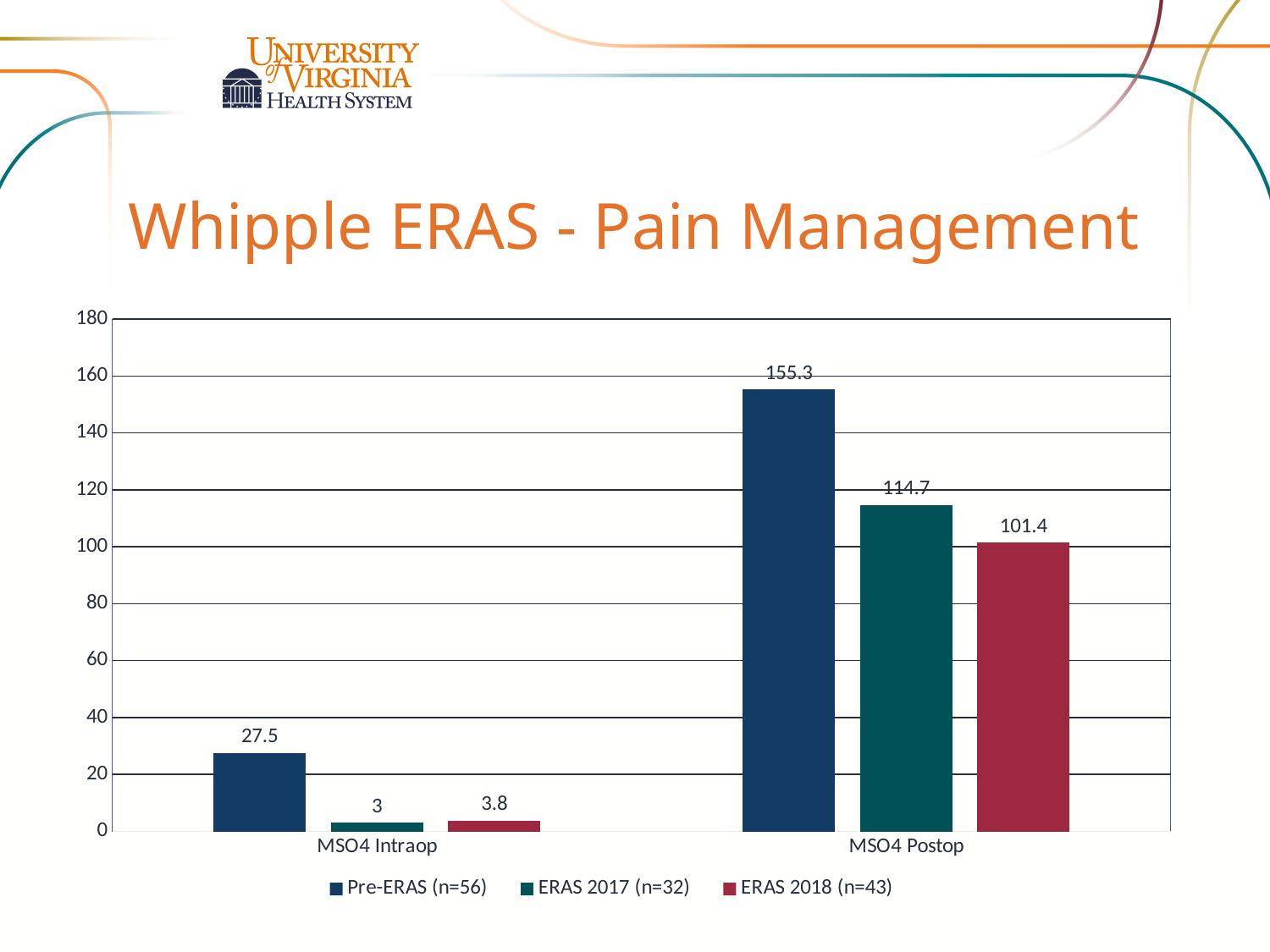
Which series has the lowest value for MSO4 Intraop? ERAS 2017 (n=32) What is the ERAS 2017 (n=32) value for MSO4 Intraop? 3 How many series does the legend list? 3 What kind of chart is shown on the slide? Bar chart Is the ERAS 2017 (n=32) value for MSO4 Postop greater or less than 100? greater Which series has the highest value for MSO4 Postop? Pre-ERAS (n=56) What is the difference between the Pre-ERAS (n=56) and ERAS 2018 (n=43) values for MSO4 Postop? 53.9 What is the ERAS 2018 (n=43) value for MSO4 Postop? 101.4 What is the title of the slide? Whipple ERAS - Pain Management How many categories are shown on the x axis? 2 What is the Pre-ERAS (n=56) value for MSO4 Postop? 155.3 Which is larger for MSO4 Intraop: the Pre-ERAS (n=56) value or the ERAS 2018 (n=43) value? Pre-ERAS (n=56)